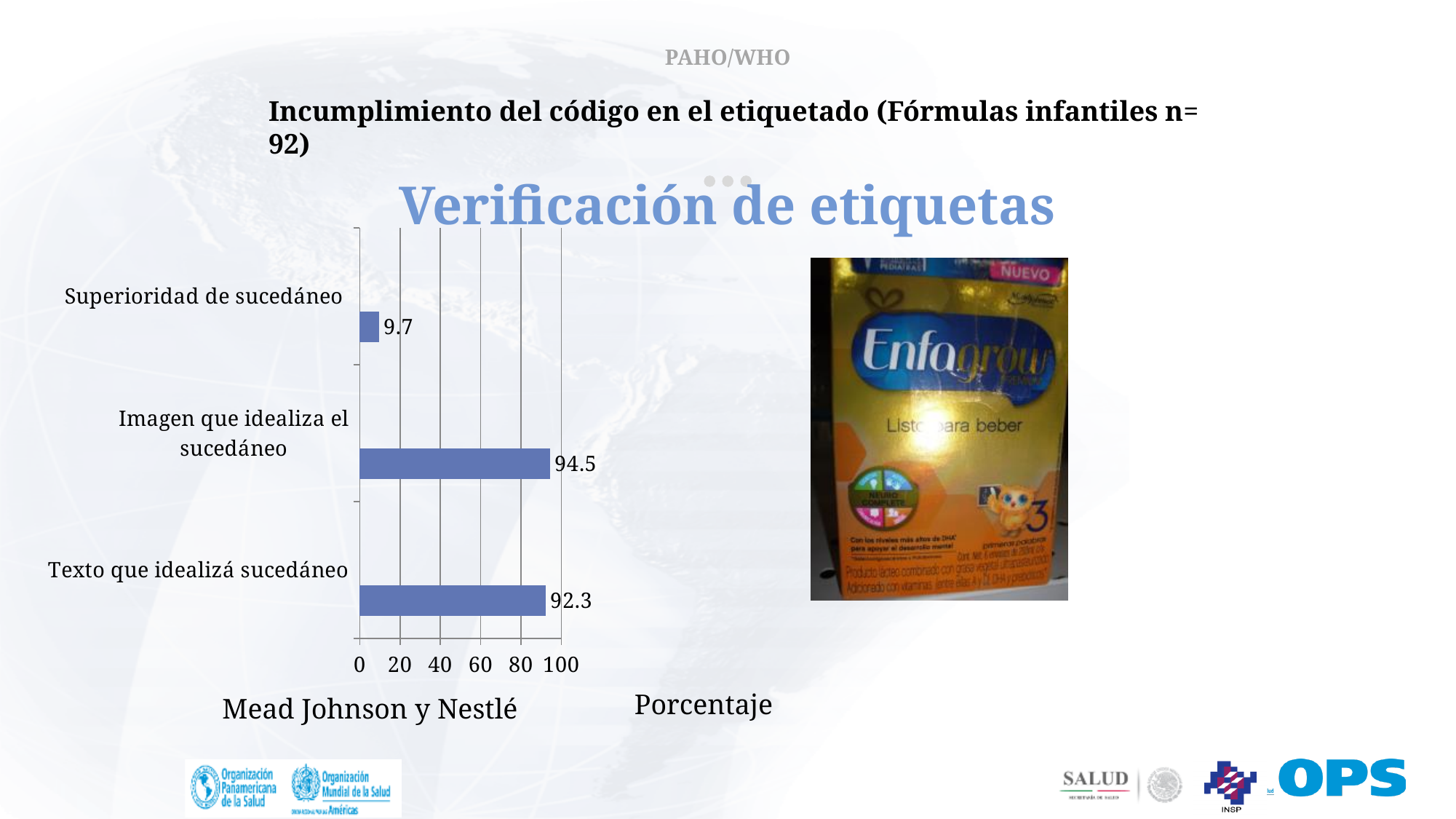
Which is larger, the value for "Superioridad de sucedáneo" or the value for "Texto que idealizá sucedáneo"? Texto que idealizá sucedáneo Is the value for "Superioridad de sucedáneo" greater or less than 20? less What is the value for "Superioridad de sucedáneo"? 9.7 Which category has the highest value? Imagen que idealiza el sucedáneo What is the value for "Imagen que idealiza el sucedáneo"? 94.5 What is the value for "Texto que idealizá sucedáneo"? 92.3 How many categories are shown in the chart? 3 What is the label of the horizontal axis of the chart? Porcentaje What kind of chart is shown on the slide? bar chart What is the difference between the values for "Imagen que idealiza el sucedáneo" and "Texto que idealizá sucedáneo"? 2.2 Which category has the lowest value? Superioridad de sucedáneo What is the difference between the values for "Texto que idealizá sucedáneo" and "Superioridad de sucedáneo"? 82.6